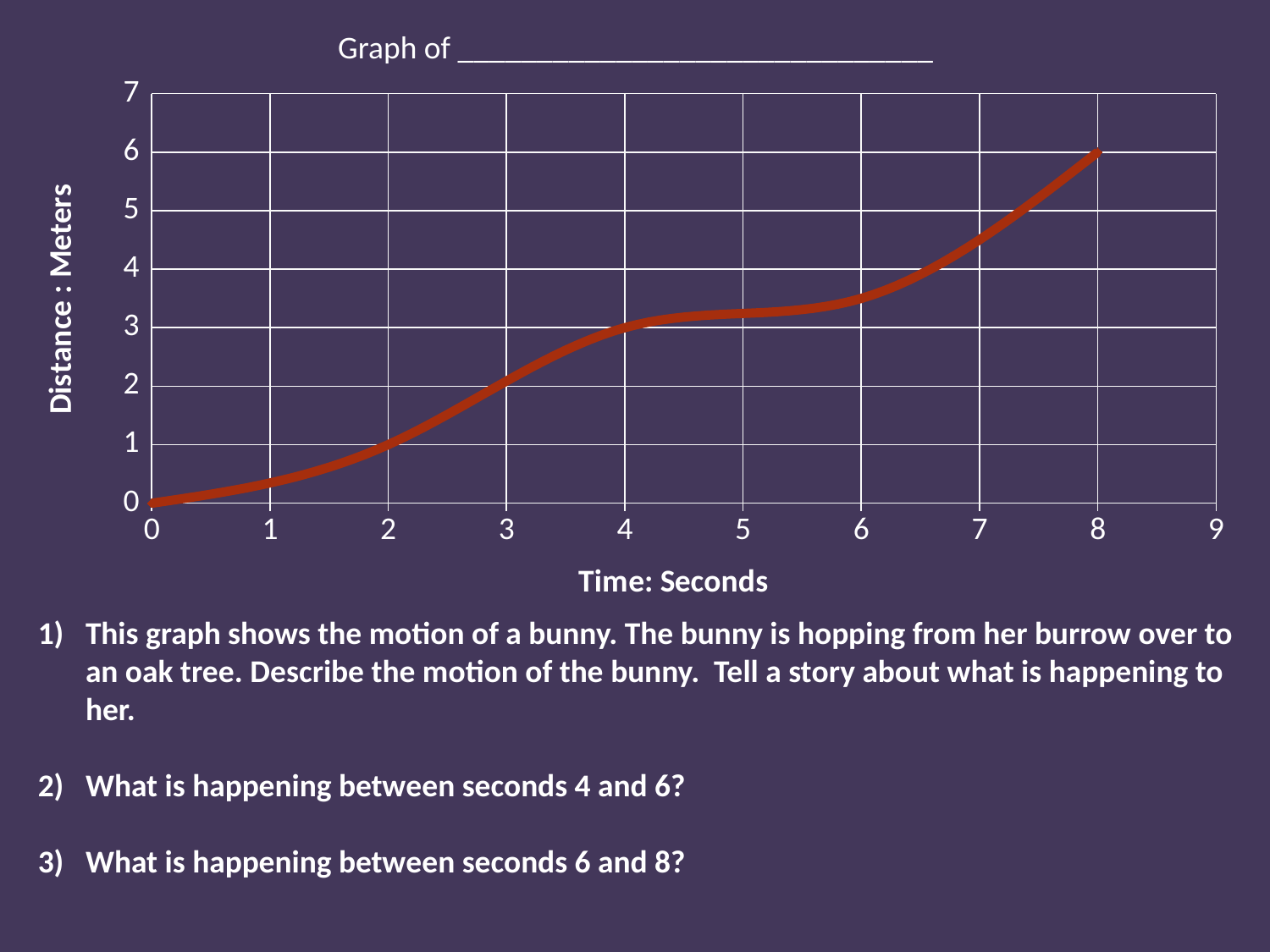
What is the distance in meters at 4 seconds? 3 Is the distance at 6 seconds greater or less than 4 meters? less What is the distance in meters at 2 seconds? 1 At what time in seconds does the line reach its highest distance? 8 What kind of chart is shown on the slide? line chart Does the distance rise or fall as time increases along the x axis? rise What is the label of the vertical axis? Distance : Meters By how many meters does the distance increase between 4 seconds and 8 seconds? 3 What is the distance in meters at 8 seconds? 6 Is the distance at 7 seconds greater or less than 4 meters? greater At what time in seconds is the distance lowest? 0